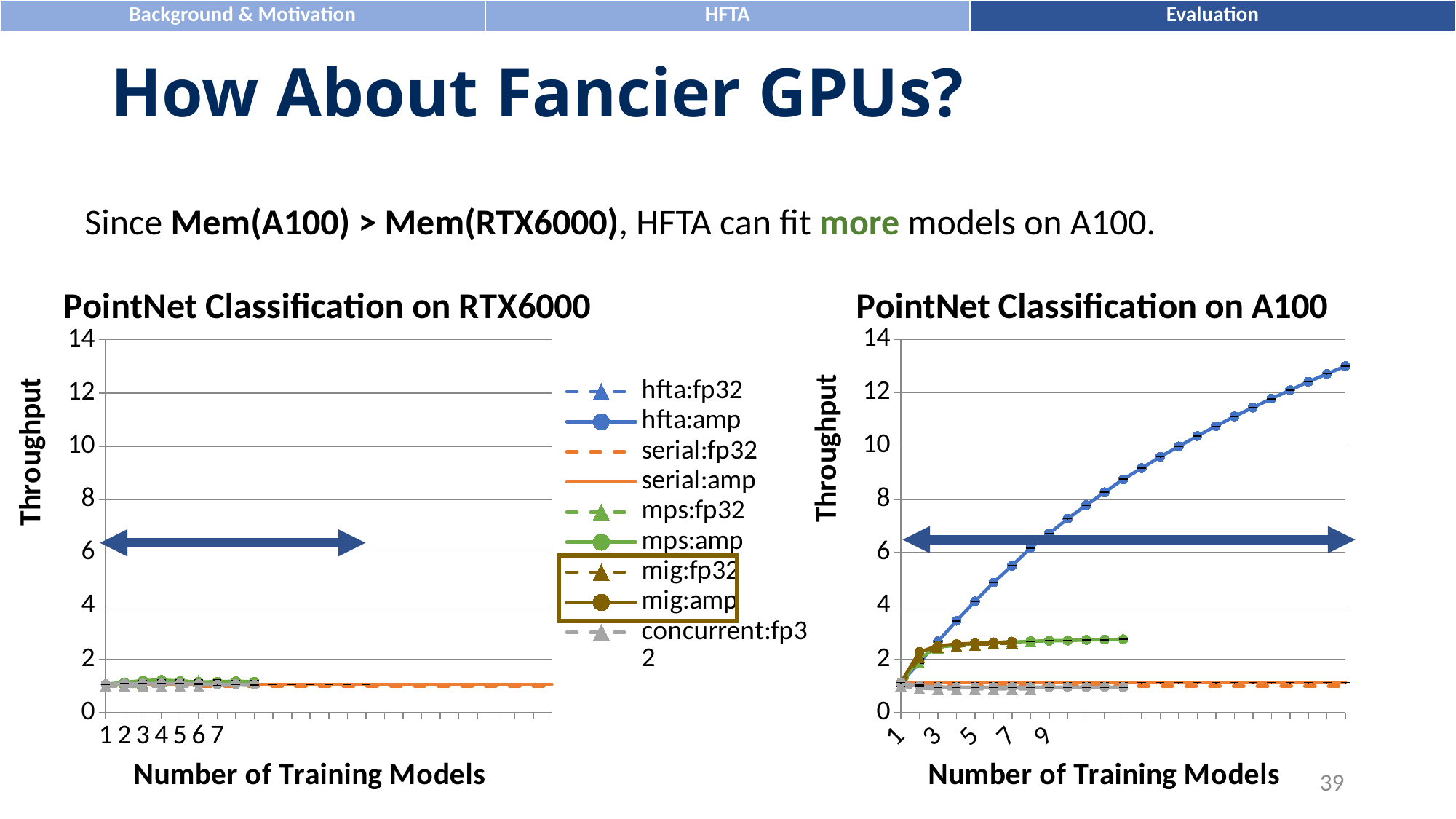
What kind of chart is "PointNet Classification on A100"? line chart What is the y-axis label of the "PointNet Classification on A100" chart? Throughput In "PointNet Classification on A100", is the mps:amp throughput at its rightmost point greater or less than 4? less What is the title of the chart on the left side of the slide? PointNet Classification on RTX6000 In "PointNet Classification on A100", which is larger at 9 training models: hfta:amp or mps:amp? hfta:amp What is the maximum value shown on the y-axis of the "PointNet Classification on RTX6000" chart? 14 In "PointNet Classification on A100", which series reaches the highest throughput? hfta:amp In "PointNet Classification on RTX6000", is the mps:amp throughput greater or less than 4? less In "PointNet Classification on A100", is the serial:amp throughput greater or less than 2? less In "PointNet Classification on A100", does the hfta:amp throughput rise or fall as the number of training models increases? rise How many series does the legend list? 9